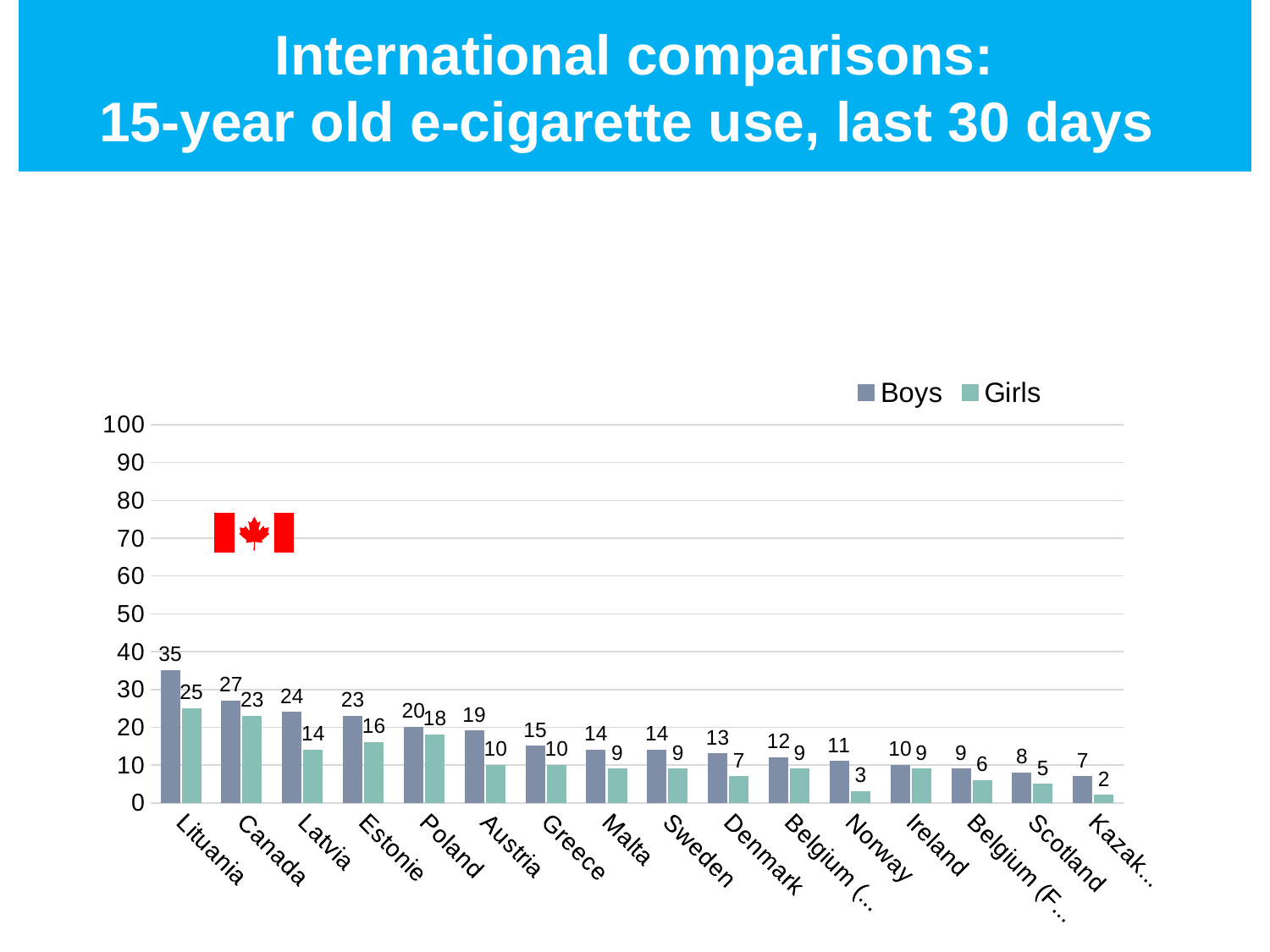
Which country has the highest value for Girls? Lituania What kind of chart is shown on the slide? Bar chart What is the value for Girls in Norway? 3 What is the difference between the Boys and Girls values for Latvia? 10 What is the value for Boys in Canada? 27 Which country has the highest value for Boys? Lituania Which is larger, the Girls value for Estonie or the Girls value for Austria? Estonie How many countries are shown on the x axis? 16 Is the value for Boys in Lituania greater or less than 30? greater What is the value for Girls in Poland? 18 How many series does the legend list? 2 What is the difference between the Boys values for Lituania and Canada? 8